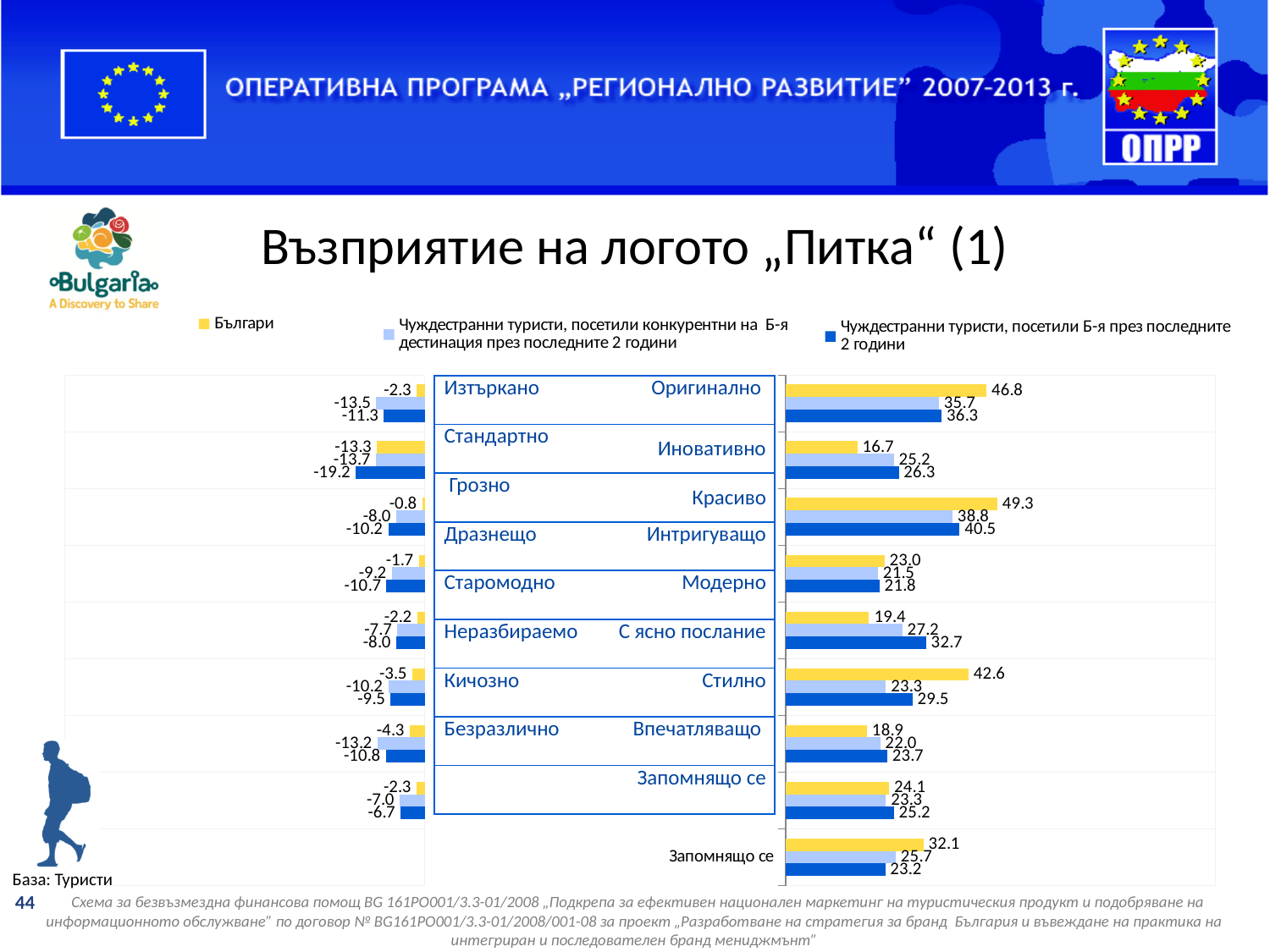
What is the largest positive value shown for Българи on the right-hand side of the chart? 49.3 In the bottom row labelled "Запомнящо се", what is the value for Българи? 32.1 Which colour represents the series Българи in the legend? yellow In the bottom row labelled "Запомнящо се", is the value for Българи larger or smaller than the value for Чуждестранни туристи, посетили конкурентни на Б-я дестинация през последните 2 години? larger What is the most negative value shown on the left-hand side of the chart? -19.2 How many series does the legend list? 3 In the bottom row labelled "Запомнящо се", what is the value for Чуждестранни туристи, посетили Б-я през последните 2 години? 23.2 In the bottom row labelled "Запомнящо се", which series has the highest value? Българи In the bottom row labelled "Запомнящо се", what is the difference between the Българи value and the value for Чуждестранни туристи, посетили Б-я през последните 2 години? 8.9 What is the title of the slide containing the chart? Възприятие на логото „Питка“ (1) What kind of chart is shown on the slide? bar chart In the bottom row labelled "Запомнящо се", what is the value for Чуждестранни туристи, посетили конкурентни на Б-я дестинация през последните 2 години? 25.7